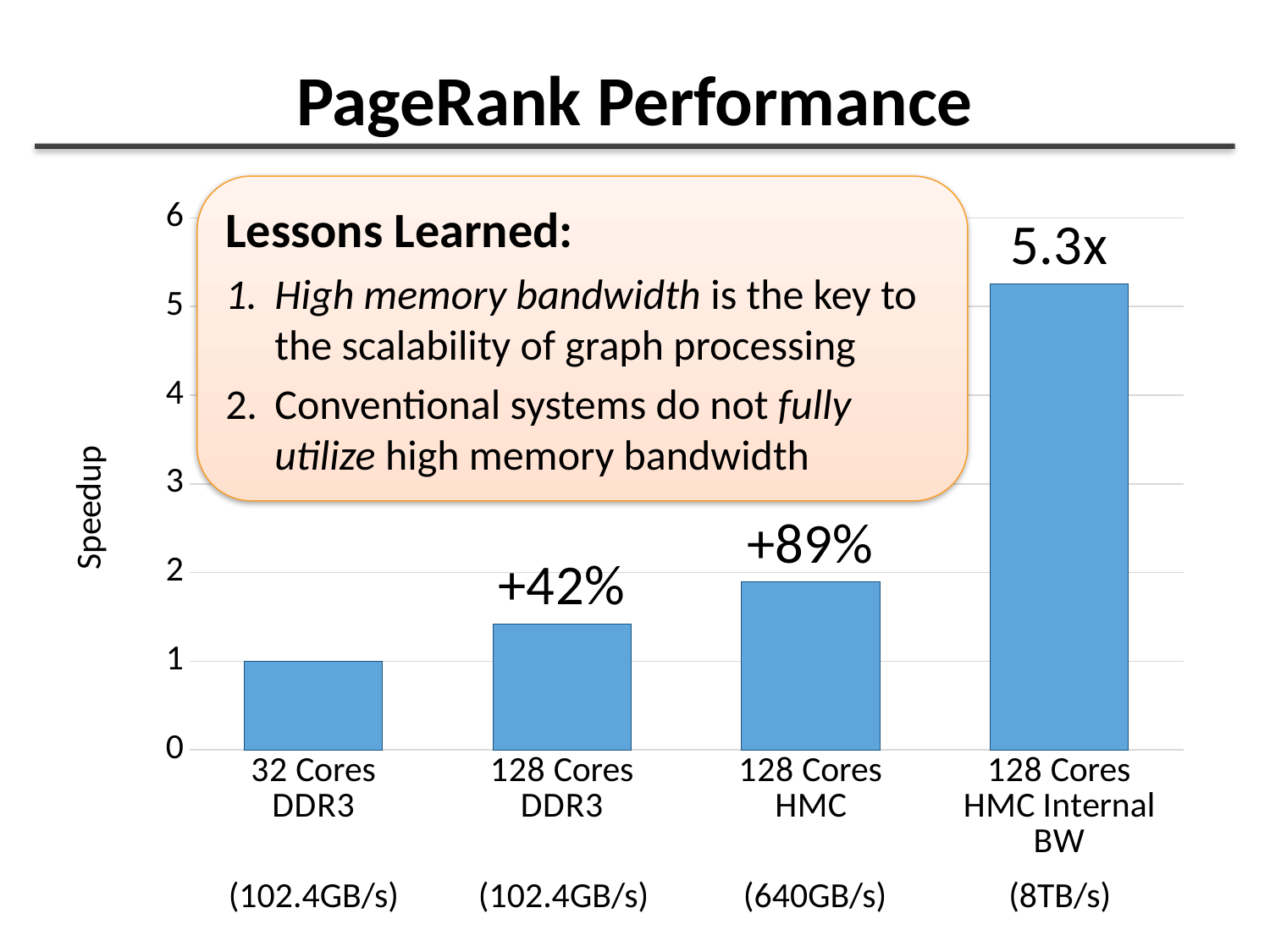
Which configuration has the lowest speedup? 32 Cores DDR3 Which configuration has the highest speedup? 128 Cores HMC Internal BW What speedup is labeled above the 128 Cores HMC Internal BW bar? 5.3x Is the speedup for 128 Cores DDR3 greater or less than 2? less Is the speedup for 128 Cores HMC greater or less than 1? greater Do the speedup values rise or fall from left to right across the categories? rise What annotation is printed above the 128 Cores HMC bar? +89% Which has a larger speedup, 128 Cores HMC or 128 Cores DDR3? 128 Cores HMC How many bars (categories) are plotted in the chart? 4 What kind of chart is shown on the slide? bar chart What is the label on the vertical axis? Speedup What is the speedup value for 32 Cores DDR3? 1